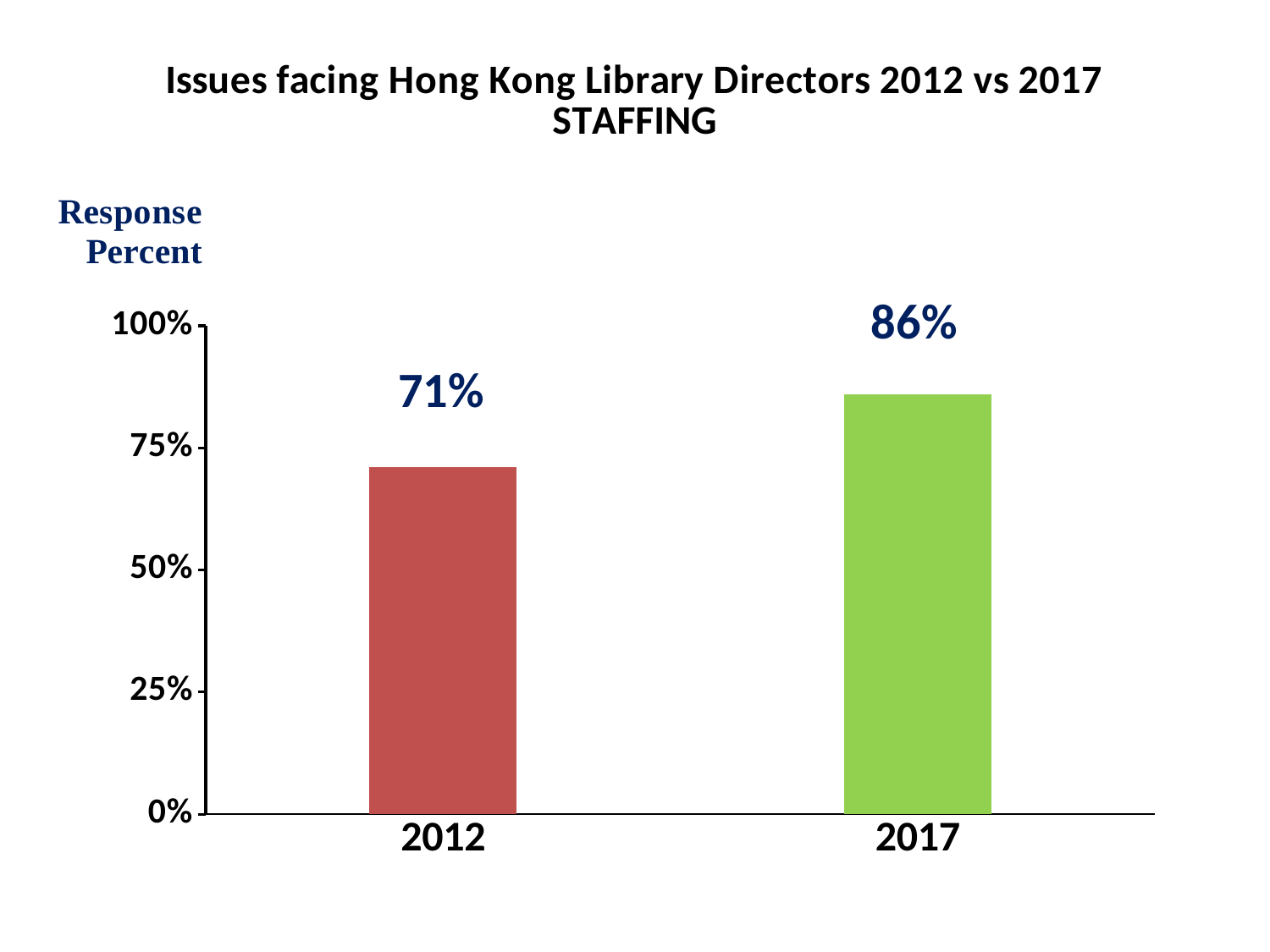
What is the response percent for 2012? 71% Is the value for 2012 greater or less than 75%? less What is the difference in response percent between 2017 and 2012? 15% Which year has the lower response percent? 2012 What is the response percent for 2017? 86% Is the response percent for 2017 larger than that for 2012? Yes Is the value for 2017 greater or less than 75%? greater Does the response percent rise or fall from 2012 to 2017? Rise How many years are shown on the chart? 2 What is the label on the vertical axis of the chart? Response Percent Which year has the higher response percent? 2017 What kind of chart is shown on the slide? Bar chart